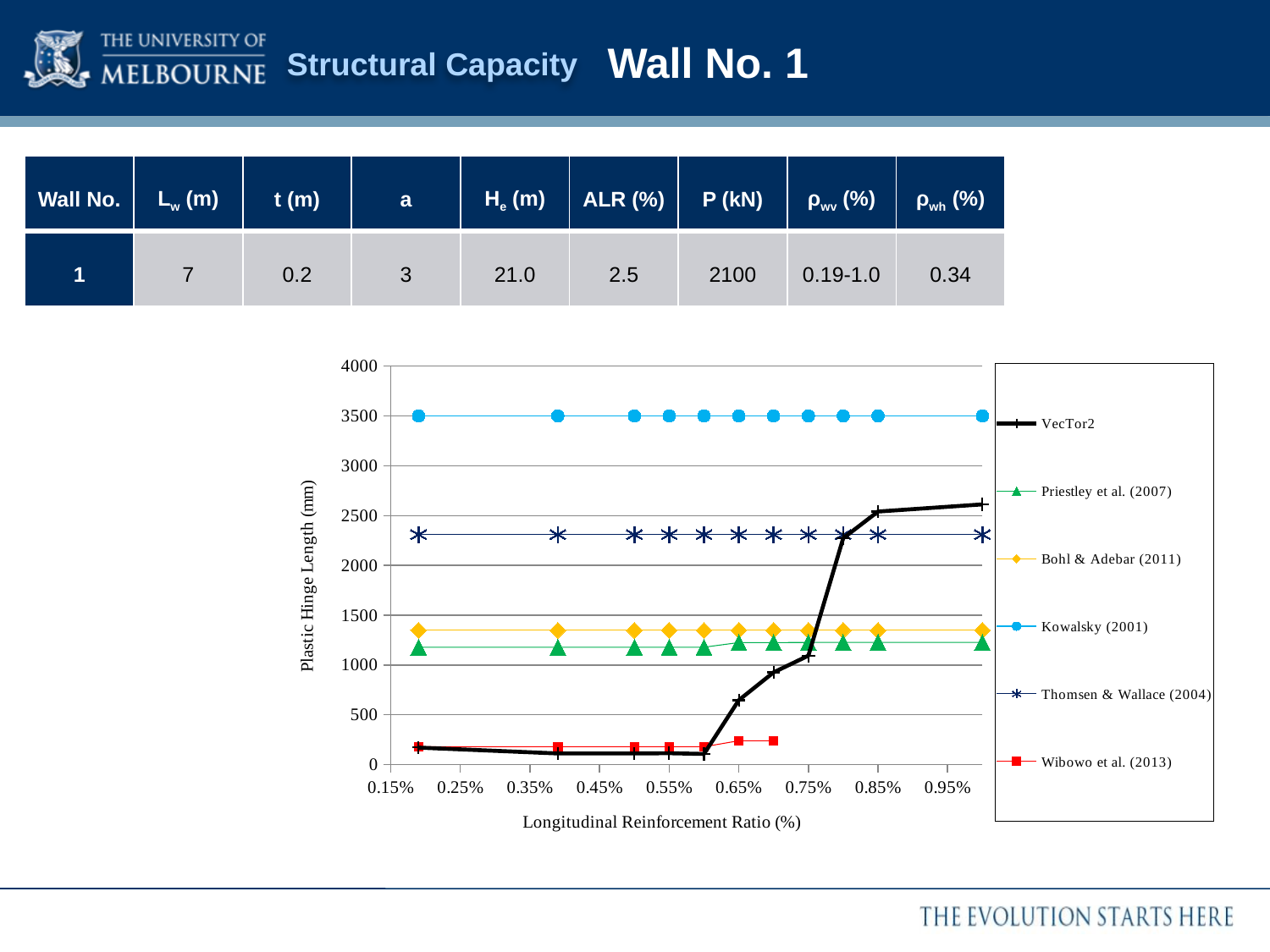
At a reinforcement ratio of 0.35%, which is larger: the Bohl & Adebar (2011) value or the Priestley et al. (2007) value? Bohl & Adebar (2011) Which series has the lowest plastic hinge length values at a reinforcement ratio of 0.55%? VecTor2 What kind of chart is shown on the slide? line chart Is the value for Wibowo et al. (2013) at 0.45% greater or less than 500? less At a reinforcement ratio of 0.85%, which is larger: the VecTor2 value or the Bohl & Adebar (2011) value? VecTor2 How many series does the chart legend list? 6 Is the value for Thomsen & Wallace (2004) greater or less than 2000? greater What is the title of the chart's y axis? Plastic Hinge Length (mm) Is the value for Kowalsky (2001) greater or less than 3000? greater What is the title of the chart's x axis? Longitudinal Reinforcement Ratio (%) Does the VecTor2 series rise or fall as the longitudinal reinforcement ratio increases? rise Which series has the highest plastic hinge length values across the chart? Kowalsky (2001)